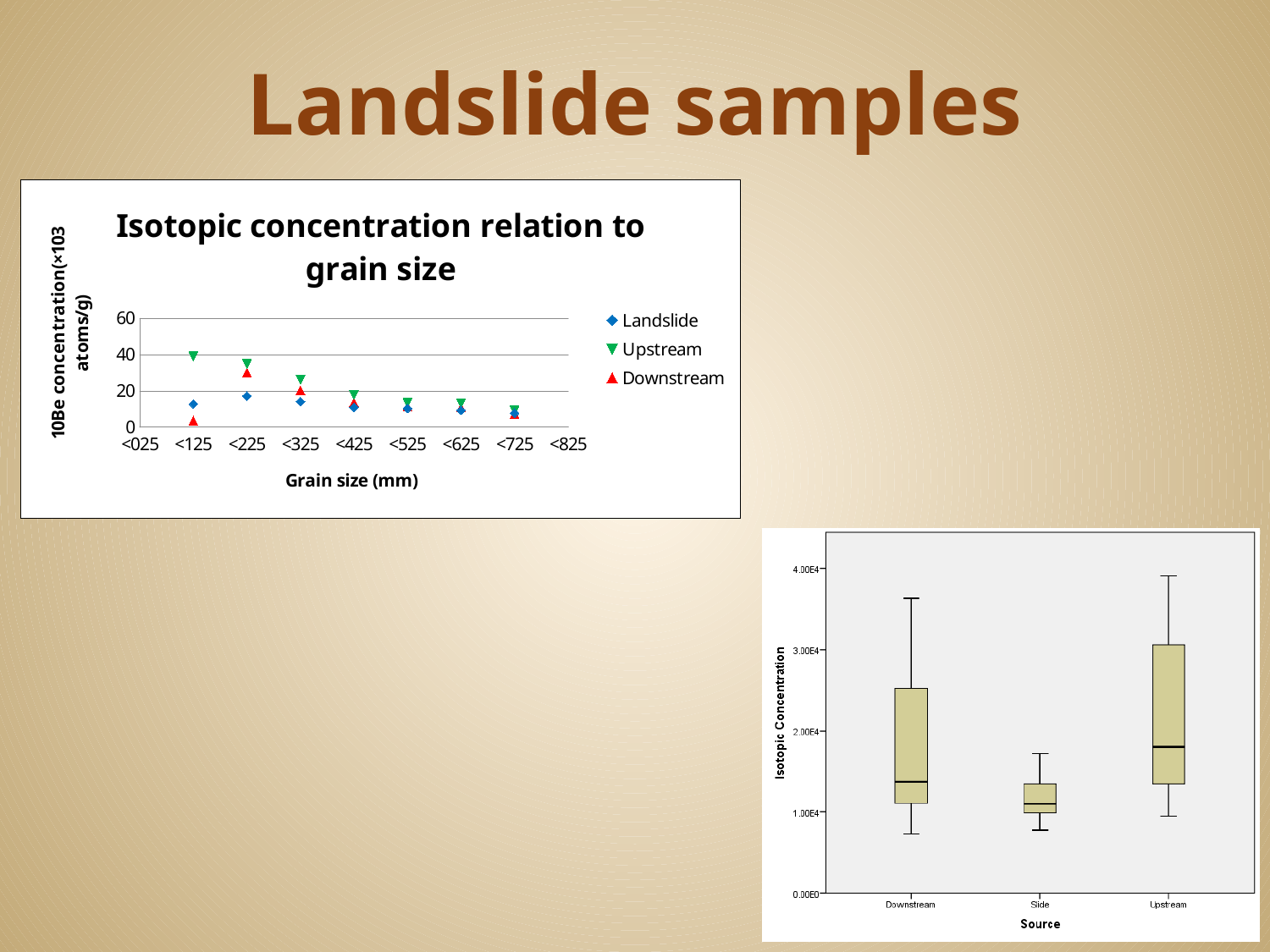
In the box plot at the bottom right, is the median isotopic concentration for Side greater or less than 2.00E4? less In the 'Isotopic concentration relation to grain size' chart, what is the x-axis title? Grain size (mm) In the box plot at the bottom right, how many source categories are shown on the x axis? 3 In the 'Isotopic concentration relation to grain size' chart, is the Landslide value at grain size <125 greater or less than 20? less In the 'Isotopic concentration relation to grain size' chart, what are the series named in the legend? Landslide, Upstream, Downstream In the 'Isotopic concentration relation to grain size' chart, how many series does the legend list? 3 In the 'Isotopic concentration relation to grain size' chart, is the Upstream value at grain size <225 greater or less than 20? greater In the 'Isotopic concentration relation to grain size' chart, do the Upstream values rise or fall as grain size increases along the x axis? fall In the 'Isotopic concentration relation to grain size' chart, at grain size <125, which series has the larger value: Upstream or Downstream? Upstream In the box plot at the bottom right, which source has the lowest median isotopic concentration? Side In the 'Isotopic concentration relation to grain size' chart, which series has the highest plotted value overall? Upstream